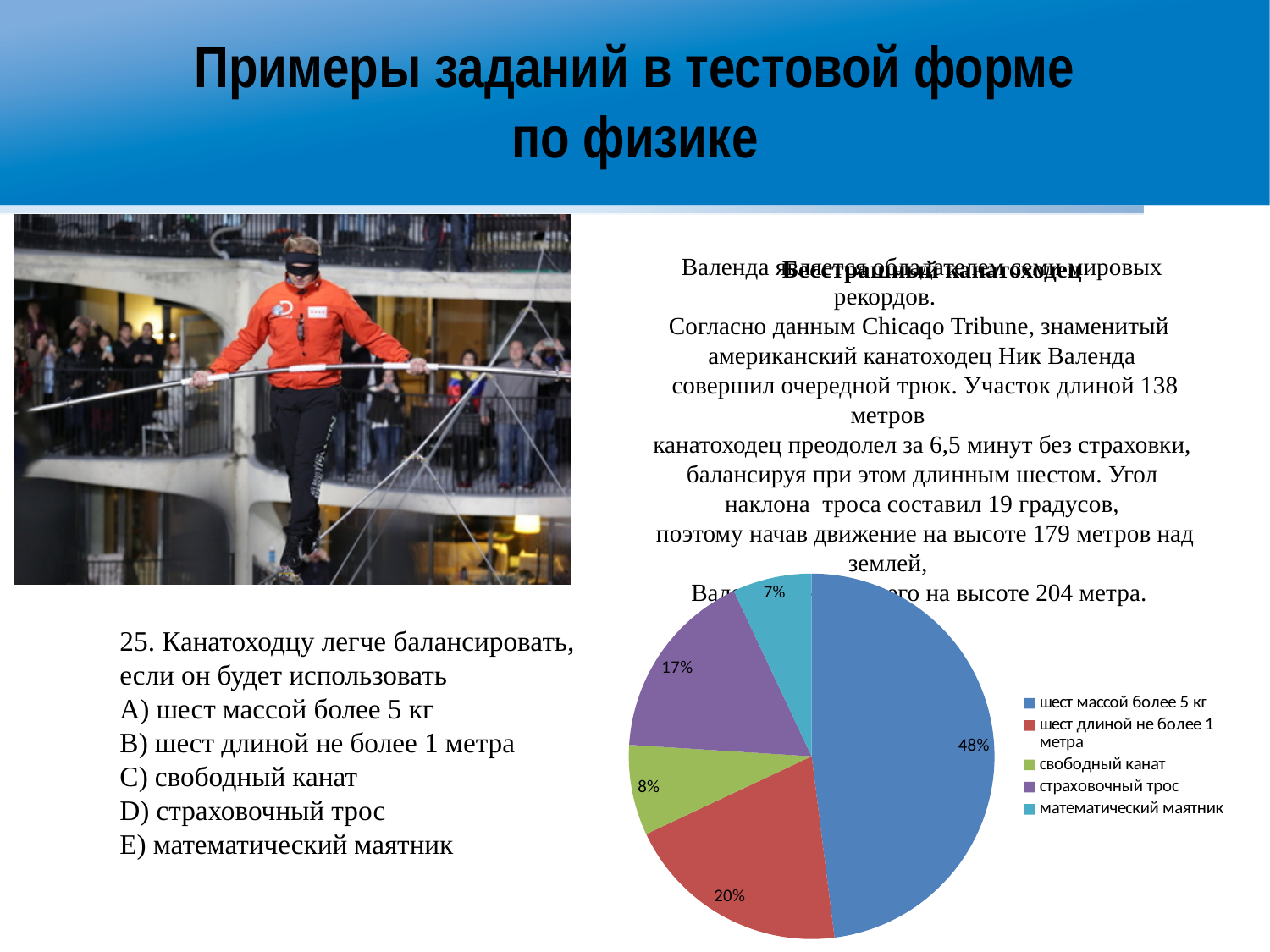
What share of the pie does "свободный канат" have? 8% Which is larger: the slice for "страховочный трос" or the slice for "свободный канат"? страховочный трос What share of the pie does "страховочный трос" have? 17% What kind of chart is shown on the slide? pie chart What is the difference in percentage points between "шест массой более 5 кг" and "шест длиной не более 1 метра"? 28 Which category has the smallest slice of the pie? математический маятник What share of the pie does "шест длиной не более 1 метра" have? 20% What share of the pie does "математический маятник" have? 7% What share of the pie does "шест массой более 5 кг" have? 48% What colour is the slice for "свободный канат"? green Which category has the largest slice of the pie? шест массой более 5 кг How many categories does the pie chart have? 5